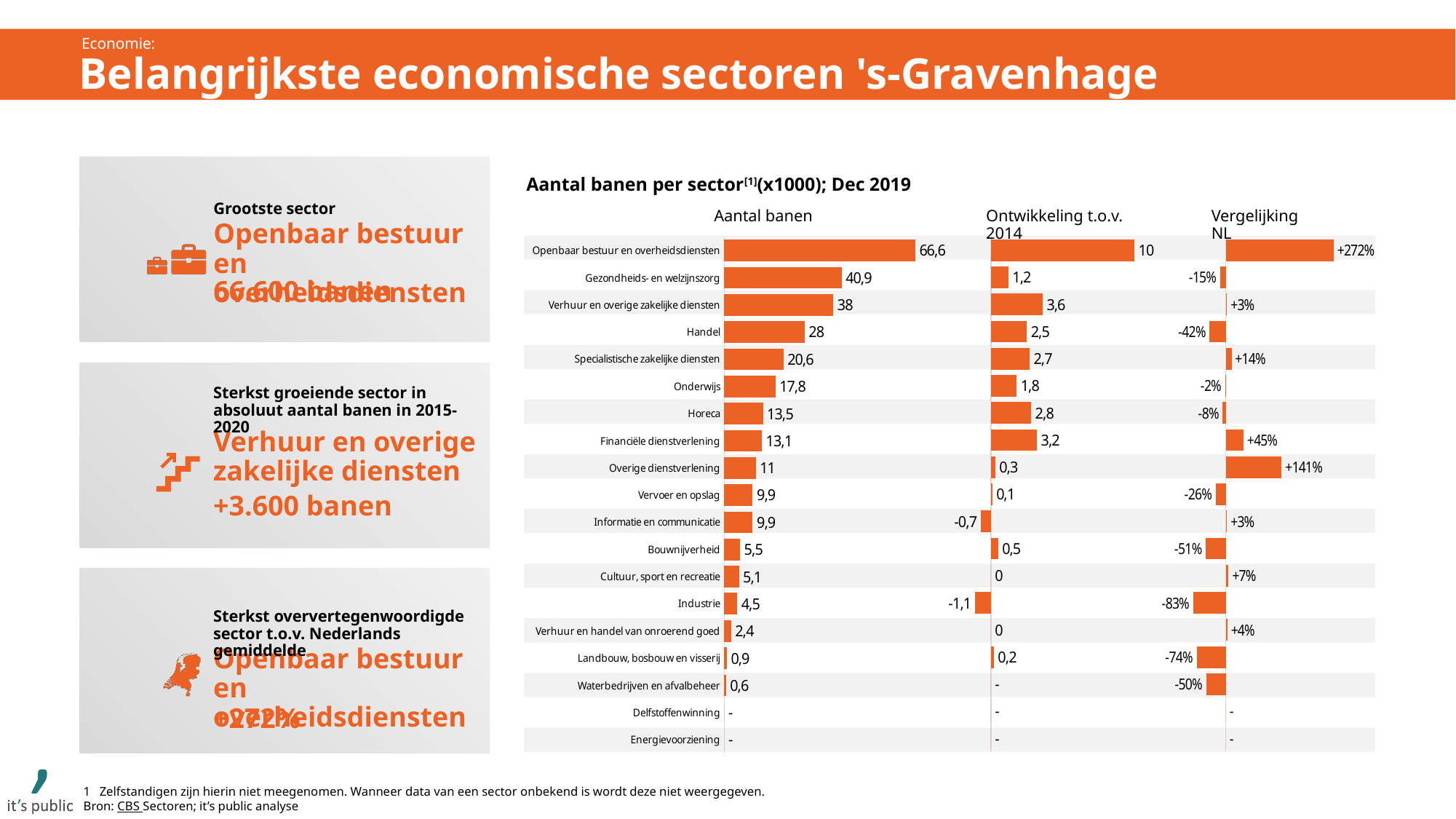
What is the title of the chart? Aantal banen per sector (x1000); Dec 2019 In the 'Aantal banen' panel, which sector has the highest value? Openbaar bestuur en overheidsdiensten In the 'Ontwikkeling t.o.v. 2014' panel, which is larger: Horeca or Specialistische zakelijke diensten? Horeca In the 'Ontwikkeling t.o.v. 2014' panel, which sector has the lowest value? Industrie How many sectors are listed in the chart? 19 In the 'Aantal banen' panel, which is larger: Onderwijs or Horeca? Onderwijs In the 'Aantal banen' panel, what is the value for Handel? 28 In the 'Vergelijking NL' panel, what is the value for Overige dienstverlening? +141% In the 'Vergelijking NL' panel, which sector has the lowest value? Industrie In the 'Ontwikkeling t.o.v. 2014' panel, what is the value for Financiële dienstverlening? 3,2 In the 'Aantal banen' panel, what is the difference between Gezondheids- en welzijnszorg and Verhuur en overige zakelijke diensten? 2,9 What kind of chart is shown on the slide? Bar chart